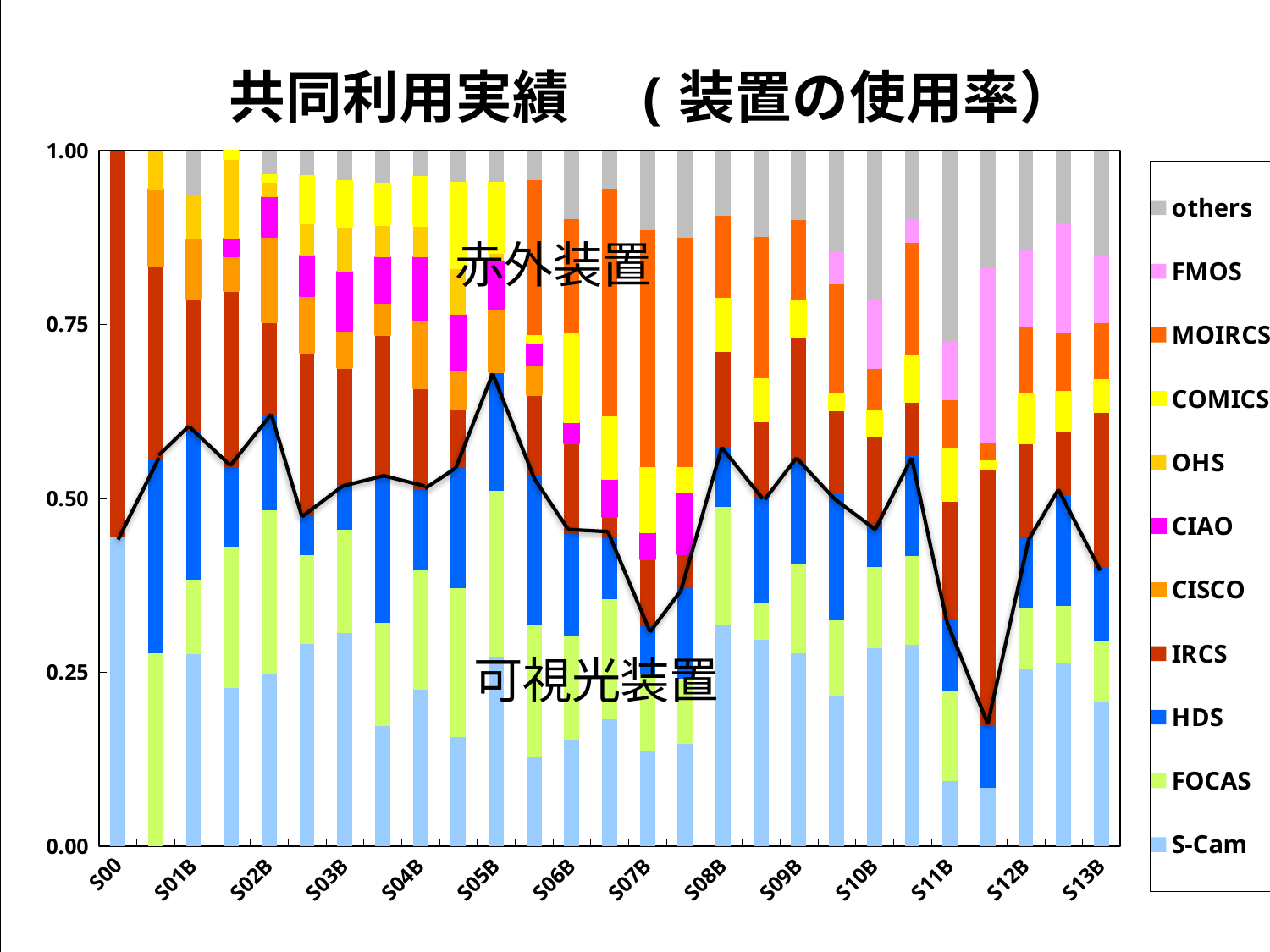
Is the value of the black line at S05B greater or less than 0.50? greater What kind of chart is shown on the slide? bar chart Is the black line higher at S05B or at S07B? S05B How many series does the legend list? 11 Is the value of the black line at S07B greater or less than 0.50? less What is the total height of the stacked bar for S00? 1.00 What is the title of the chart? 共同利用実績 （装置の使用率） Which legend entry appears at the bottom of the legend? S-Cam How many category labels are shown on the x axis? 14 Is the S-Cam value for S13B greater or less than 0.25? less Among the labeled categories, at which one does the black line reach its highest value? S05B